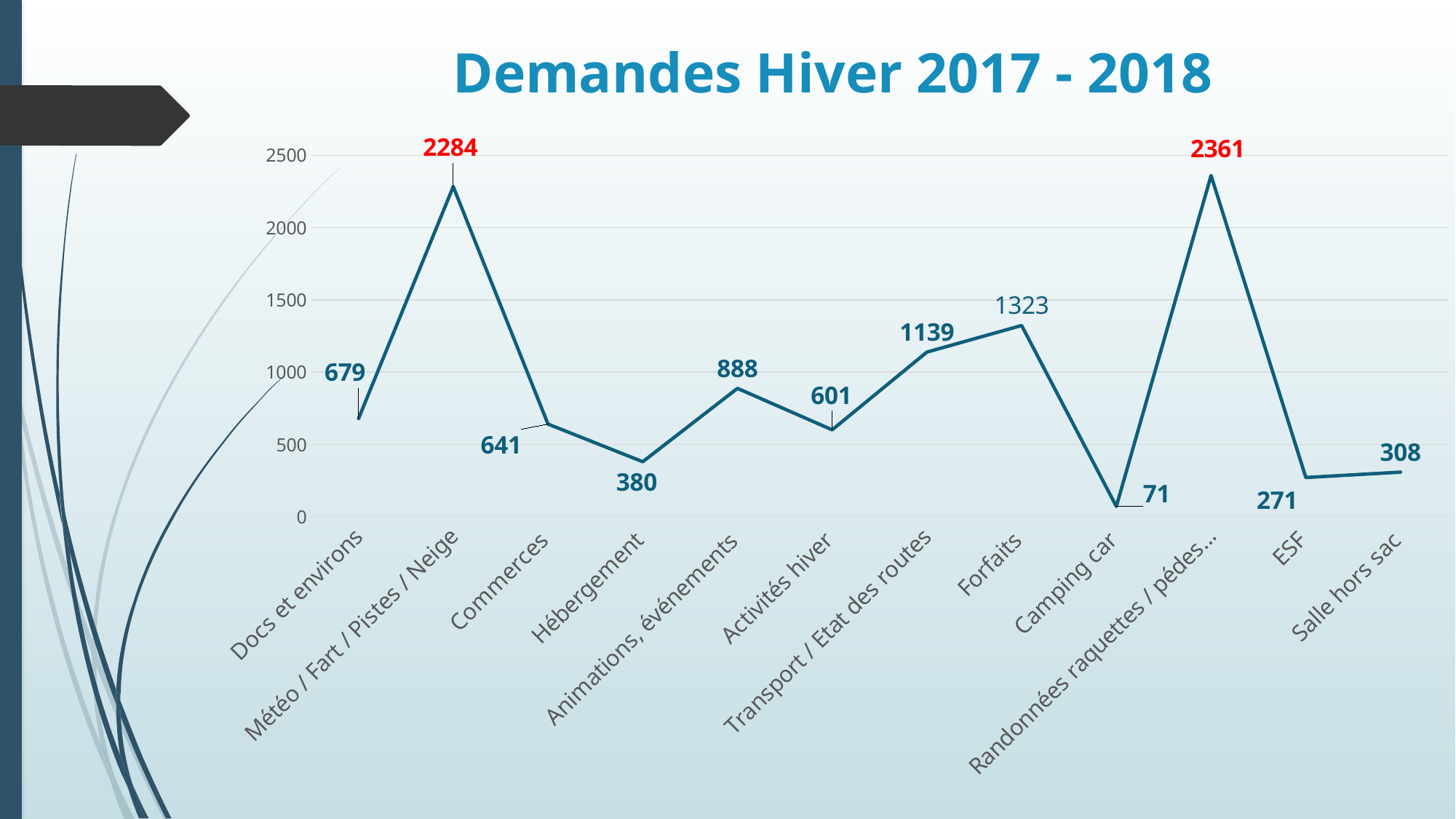
What is the value for Docs et environs? 679 What is the value for Camping car? 71 What is the value for Météo / Fart / Pistes / Neige? 2284 Which category has the highest value? Randonnées raquettes / pédes... What is the value for Forfaits? 1323 Which is larger, the value for Commerces or the value for Hébergement? Commerces What is the title of the chart? Demandes Hiver 2017 - 2018 Does the value rise or fall from ESF to Salle hors sac? rise What type of chart is shown on the slide? line chart How many categories are plotted on the x axis? 12 What is the difference between the values for Transport / Etat des routes and Activités hiver? 538 Which category has the lowest value? Camping car